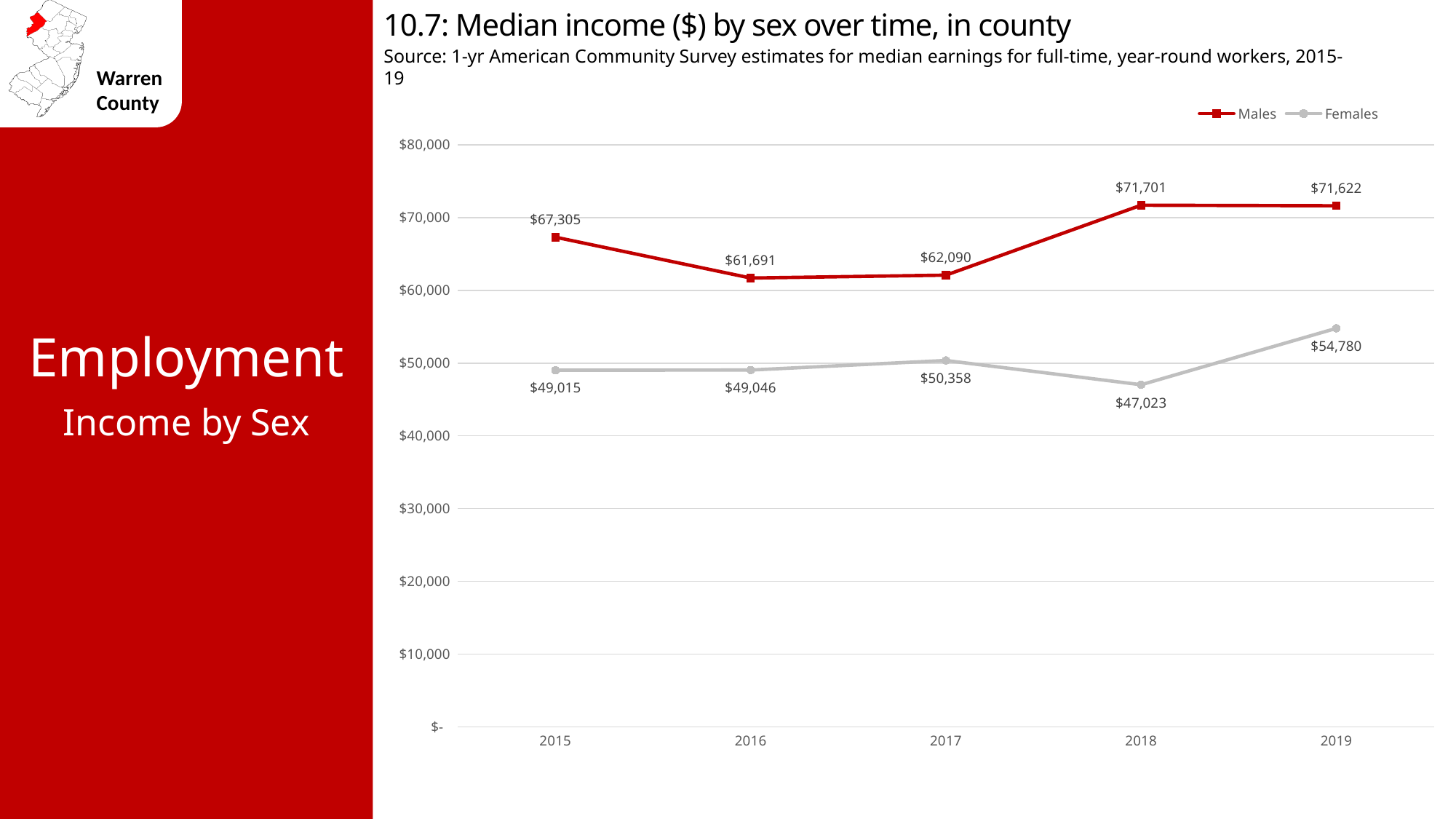
What is the difference between the Males and Females median income in 2019? $16,842 Did the median income for Males rise or fall from 2015 to 2016? Fall What kind of chart is shown on the slide? Line chart Is the median income for Females in 2019 greater or less than $50,000? greater How many years are shown on the x axis? 5 What was the median income for Females in 2018? $47,023 In which year was the median income for Females lowest? 2018 Which was larger in 2017, the median income for Males or for Females? Males What was the median income for Males in 2015? $67,305 How many series does the legend list? 2 In which year was the median income for Males highest? 2018 What was the median income for Females in 2019? $54,780